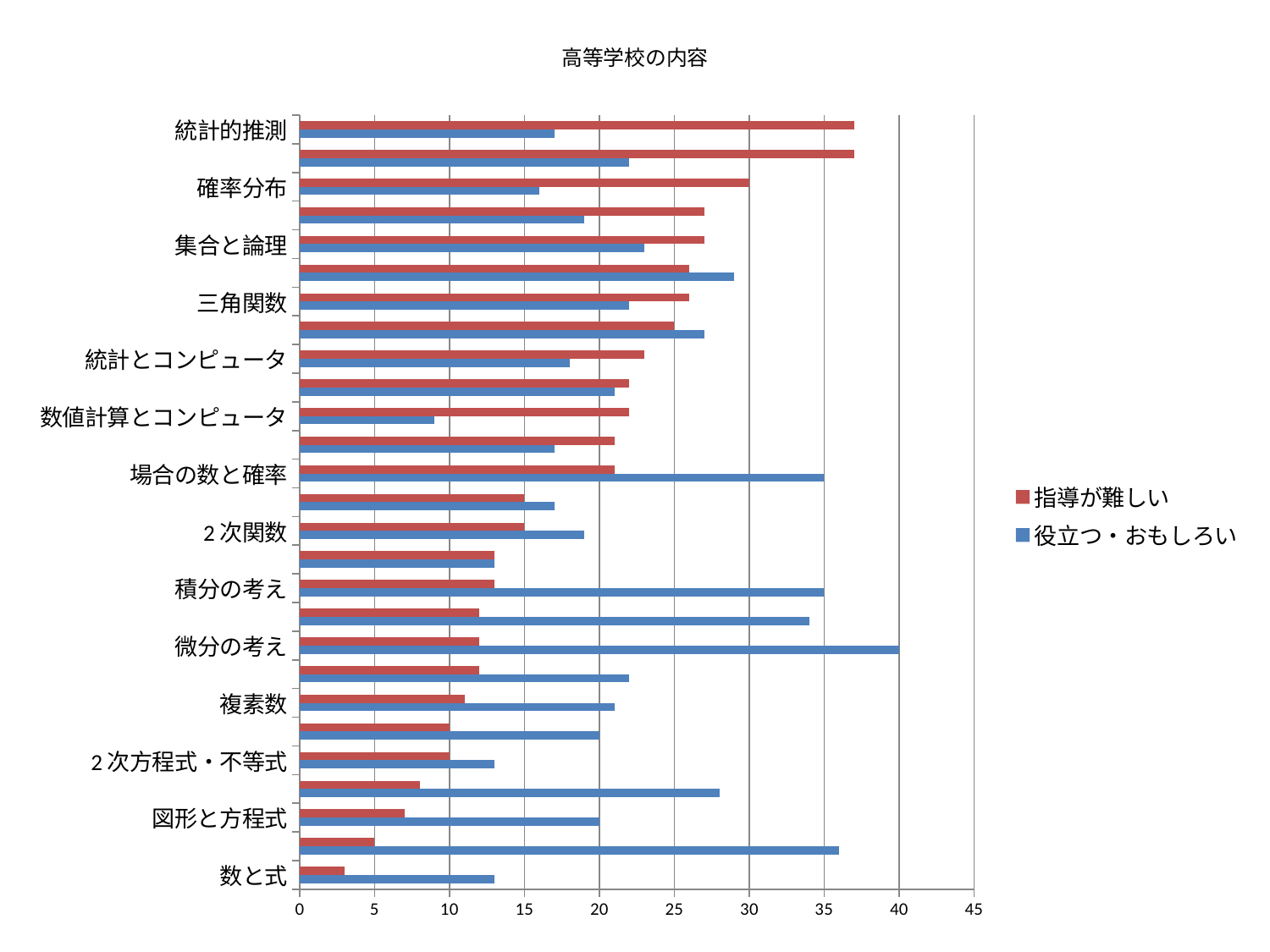
How many series does the legend list? 2 Which series is shown in blue in the legend? 役立つ・おもしろい Is the 指導が難しい value for 数と式 greater or less than 5? less Is the 指導が難しい value for 統計的推測 greater or less than 35? greater What kind of chart is shown on the slide? bar chart Is the 指導が難しい value for 図形と方程式 greater or less than 10? less For 数値計算とコンピュータ, which series has the larger value, 指導が難しい or 役立つ・おもしろい? 指導が難しい What is the title of the chart? 高等学校の内容 Which category has the lowest 指導が難しい value? 数と式 For 積分の考え, which series has the larger value, 指導が難しい or 役立つ・おもしろい? 役立つ・おもしろい